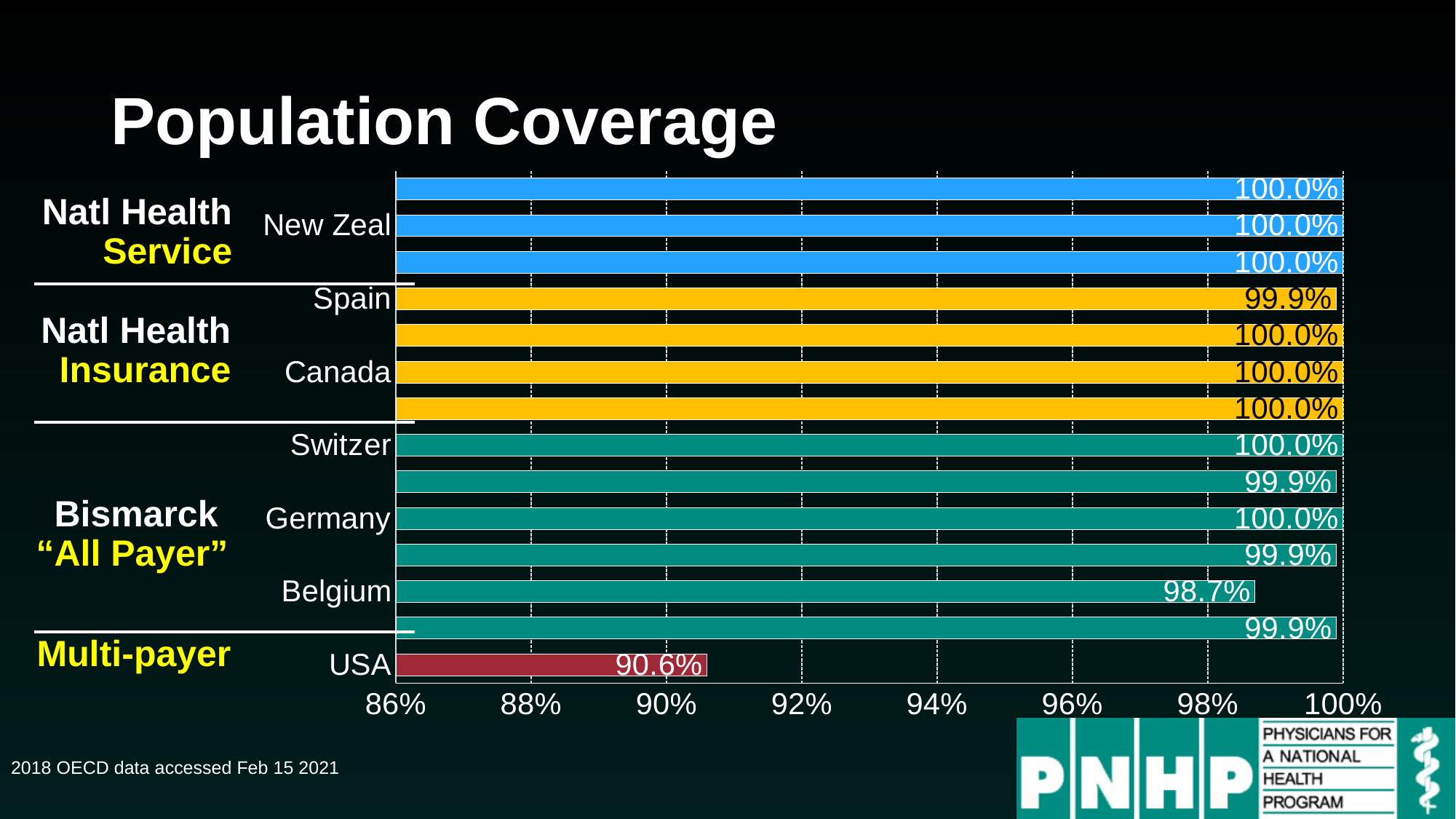
Which country has the lowest population coverage on the chart? USA How many bars are plotted on the chart? 14 What is the population coverage value shown for Spain? 99.9% Which has the larger population coverage, Belgium or USA? Belgium Is the population coverage value for USA greater or less than 92%? less What is the title of the chart? Population Coverage What is the difference in population coverage between Belgium and USA? 8.1 percentage points What is the population coverage value shown for USA? 90.6% What kind of chart is shown on the slide? bar chart What is the population coverage value shown for Germany? 100.0% What is the population coverage value shown for Belgium? 98.7% What is the population coverage value shown for Canada? 100.0%